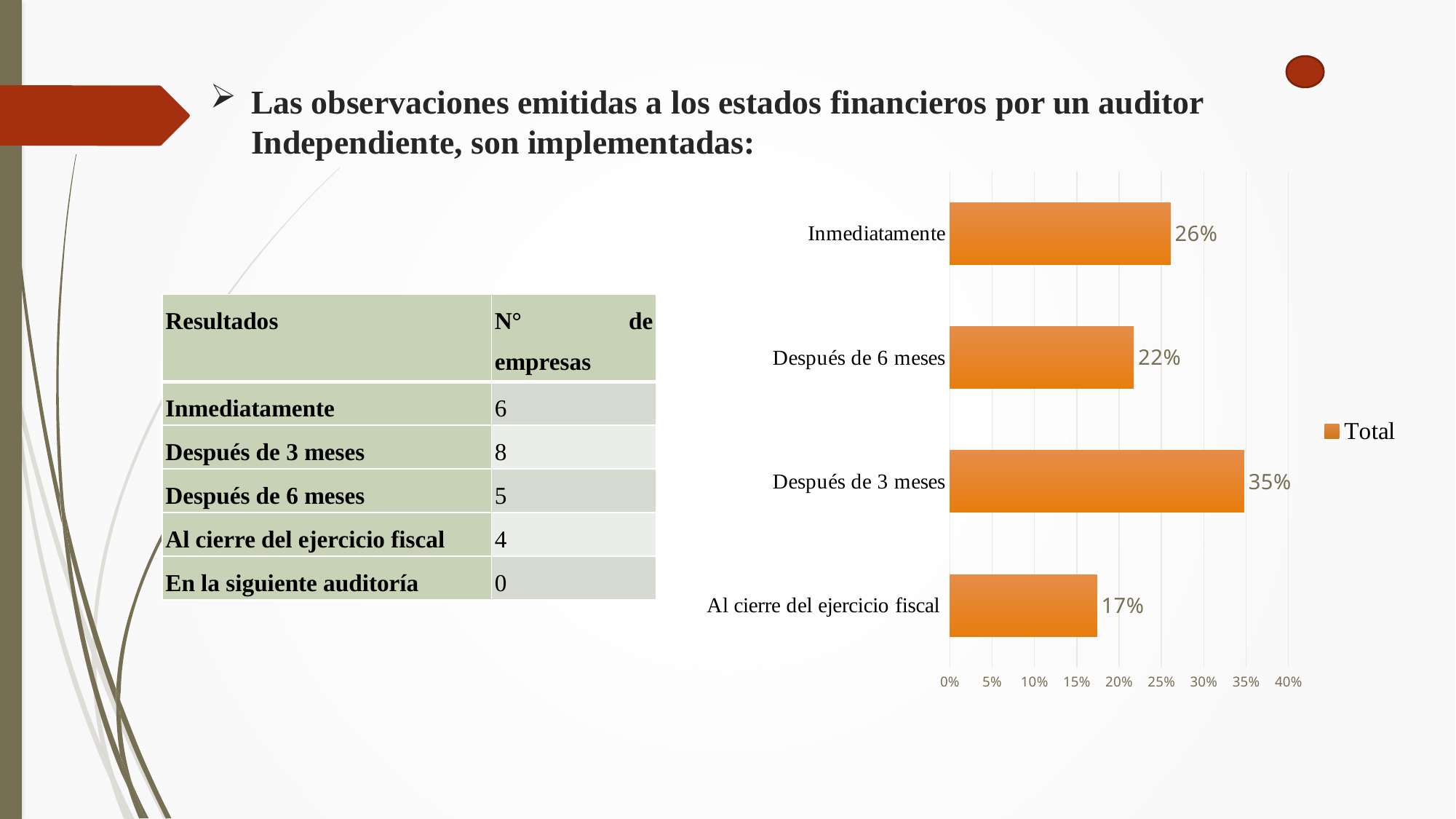
What is the value for Inmediatamente in the bar chart? 26% What is the value for Después de 3 meses in the bar chart? 35% What kind of chart is shown on the slide? bar chart What is the name of the series listed in the chart's legend? Total How many categories are shown in the bar chart? 4 How many series does the legend of the bar chart list? 1 What is the difference between the values for Después de 3 meses and Después de 6 meses in the bar chart? 13% What is the value for Al cierre del ejercicio fiscal in the bar chart? 17% Which category has the lowest value in the bar chart? Al cierre del ejercicio fiscal Is the value for Después de 6 meses in the bar chart greater or less than 20%? greater Which category has the highest value in the bar chart? Después de 3 meses Which is larger in the bar chart, the value for Inmediatamente or the value for Después de 6 meses? Inmediatamente